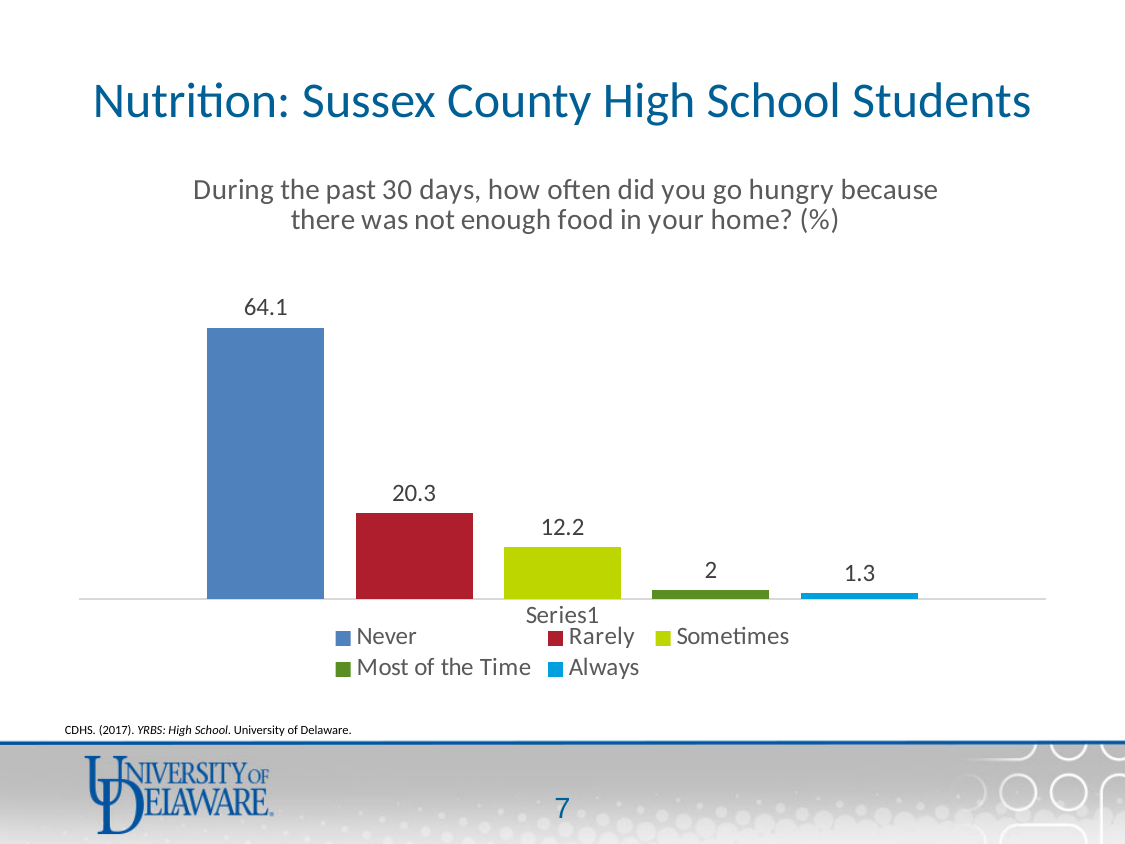
Which response has the lowest value? Always What is the value for Rarely? 20.3 What kind of chart is shown on the slide? Bar chart Which is larger, the value for Sometimes or the value for Most of the Time? Sometimes What colour is the bar for Rarely? Red What is the value for Never? 64.1 Which response has the highest value? Never How many series does the legend list? 5 What is the value for Most of the Time? 2 What is the value for Sometimes? 12.2 What is the value for Always? 1.3 What is the difference between the values for Never and Rarely? 43.8